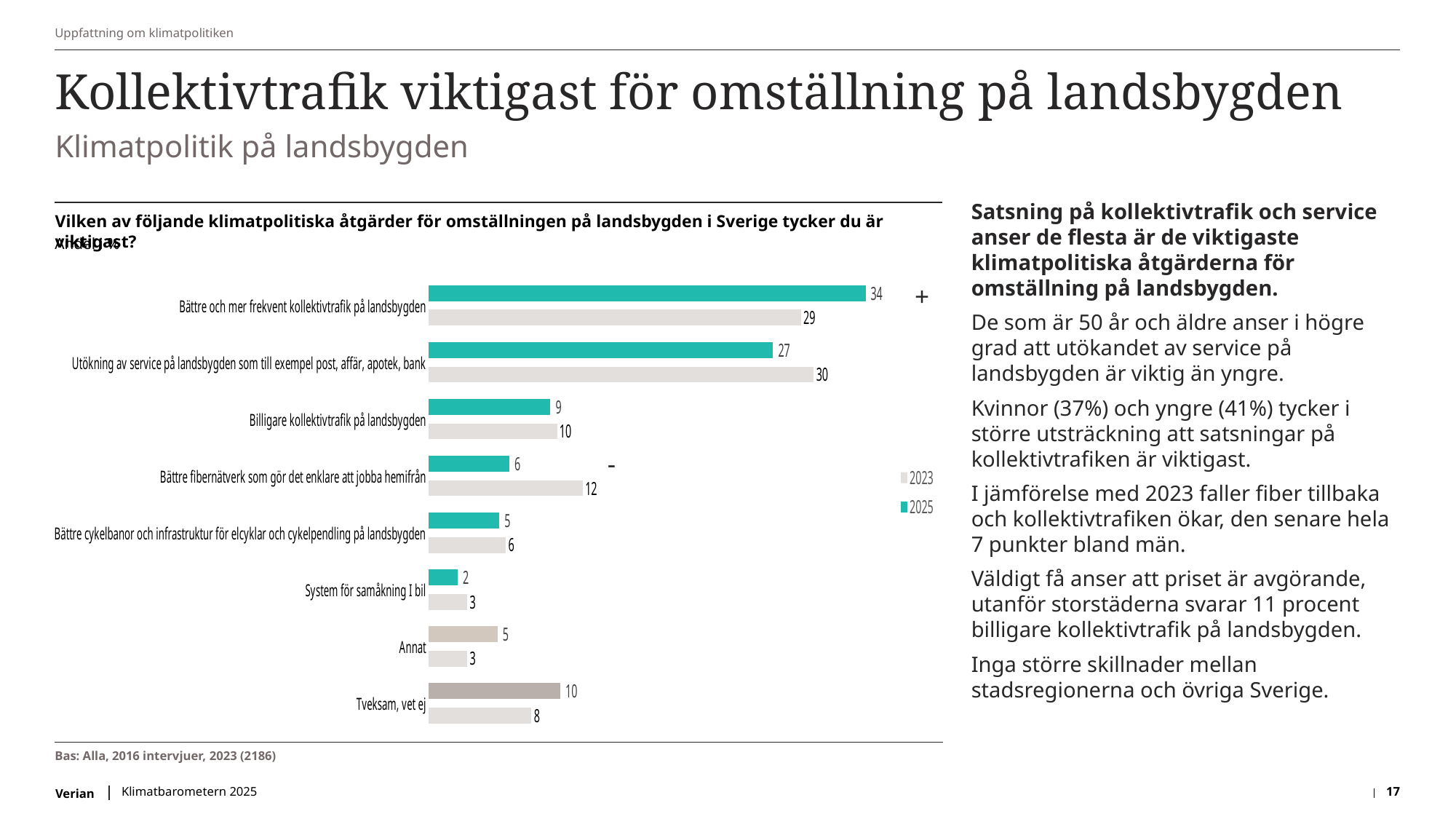
What is the 2025 value for "System för samåkning I bil"? 2 For "Utökning av service på landsbygden som till exempel post, affär, apotek, bank", which year has the larger value, 2023 or 2025? 2023 What is the difference between the 2023 and 2025 values for "Bättre fibernätverk som gör det enklare att jobba hemifrån"? 6 How many series does the legend list? 2 What is the difference between the 2025 and 2023 values for "Bättre och mer frekvent kollektivtrafik på landsbygden"? 5 How many categories are shown in the chart? 8 What is the 2023 value for "Bättre fibernätverk som gör det enklare att jobba hemifrån"? 12 Which category has the lowest 2023 value? System för samåkning I bil and Annat (both 3) What is the 2025 value for "Bättre och mer frekvent kollektivtrafik på landsbygden"? 34 Which category has the highest 2025 value? Bättre och mer frekvent kollektivtrafik på landsbygden What is the 2023 value for "Utökning av service på landsbygden som till exempel post, affär, apotek, bank"? 30 What kind of chart is shown on the slide? Bar chart